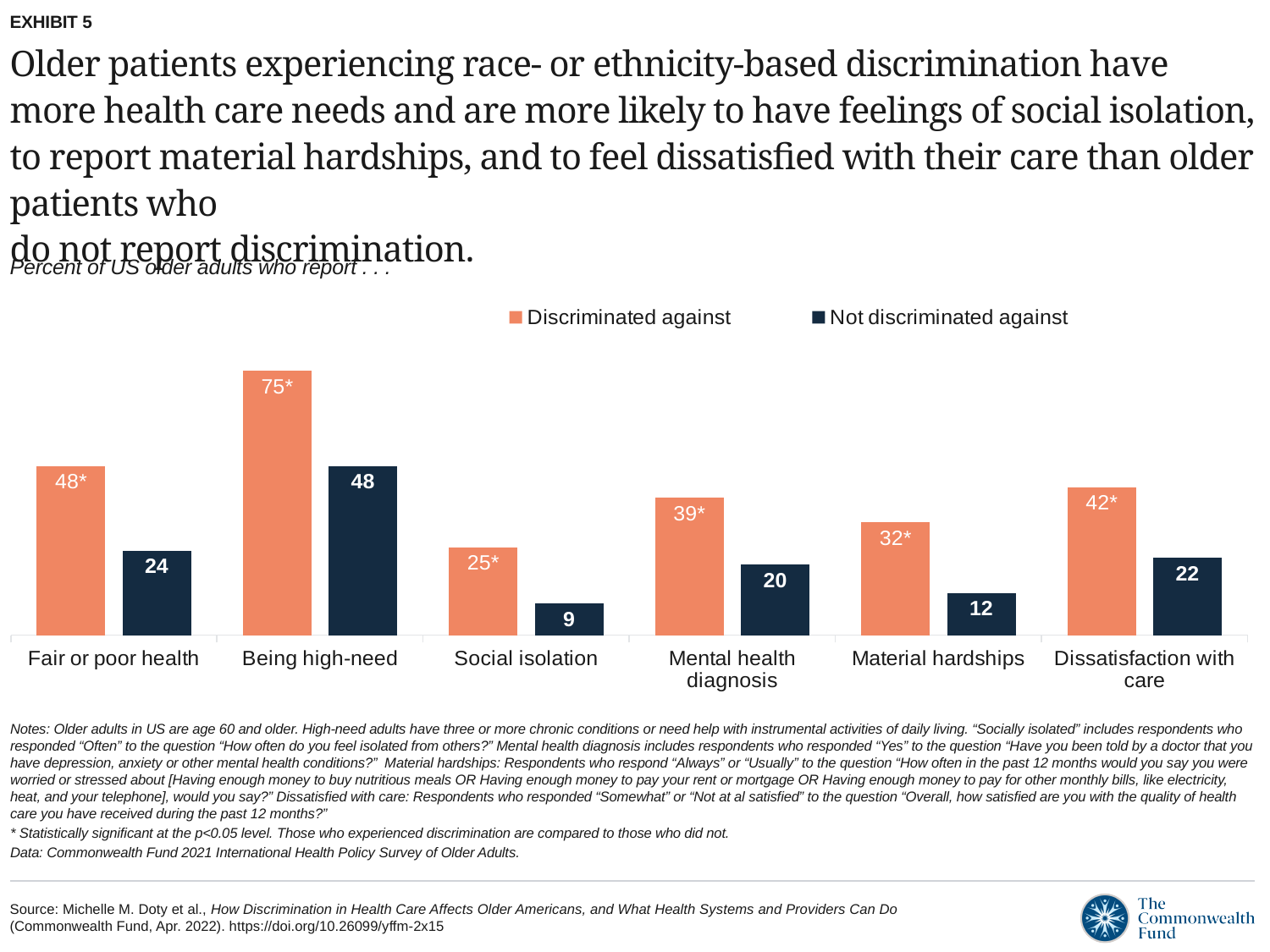
What kind of chart is shown on the slide? Bar chart Which is larger: the 'Not discriminated against' value for 'Mental health diagnosis' or for 'Dissatisfaction with care'? Dissatisfaction with care What is the value for 'Discriminated against' in the 'Material hardships' category? 32* Which category has the highest value for 'Discriminated against'? Being high-need How many categories are shown on the x axis? 6 Which category has the lowest value for 'Not discriminated against'? Social isolation What is the difference between the 'Discriminated against' and 'Not discriminated against' values for 'Material hardships'? 20 What is the value for 'Discriminated against' in the 'Being high-need' category? 75* What is the difference between the 'Discriminated against' and 'Not discriminated against' values for 'Fair or poor health'? 24 What is the value for 'Not discriminated against' in the 'Social isolation' category? 9 How many series does the legend list? 2 Which colour represents the 'Not discriminated against' series? Dark navy blue